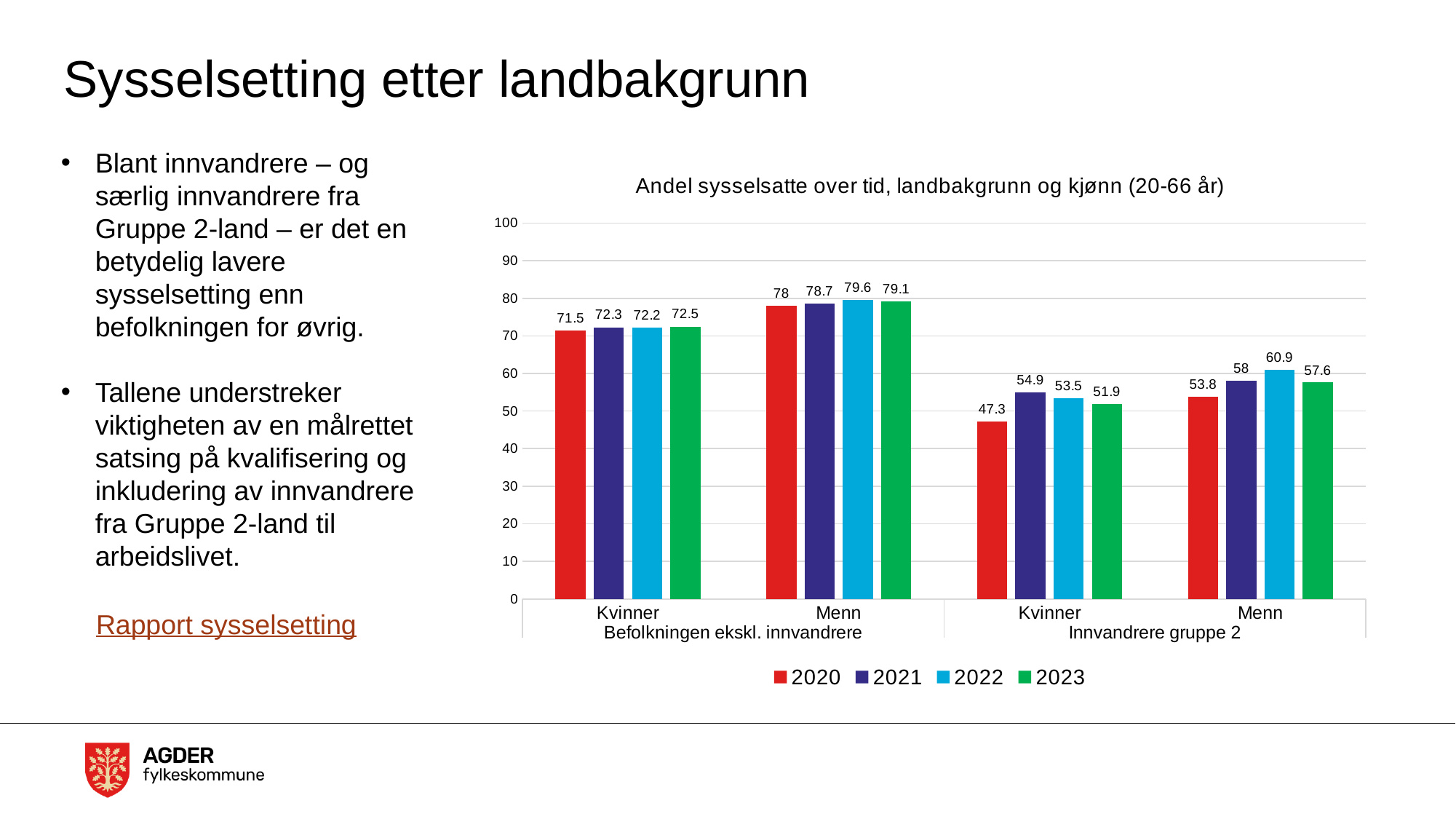
Is the 2020 value for Kvinner in Innvandrere gruppe 2 greater or less than 50? less Which year has the highest value for Menn in Befolkningen ekskl. innvandrere? 2022 What is the value for Menn in Innvandrere gruppe 2 for 2022? 60.9 Do the values for Menn in Befolkningen ekskl. innvandrere rise or fall from 2020 to 2022? Rise Which is larger: the 2021 value for Kvinner in Innvandrere gruppe 2 or the 2021 value for Menn in Innvandrere gruppe 2? Menn in Innvandrere gruppe 2 What is the value for Kvinner in Innvandrere gruppe 2 for 2023? 51.9 What is the difference between the 2023 values for Menn in Befolkningen ekskl. innvandrere and Menn in Innvandrere gruppe 2? 21.5 Which year has the lowest value for Kvinner in Innvandrere gruppe 2? 2020 What is the title of the chart? Andel sysselsatte over tid, landbakgrunn og kjønn (20-66 år) What kind of chart is shown on the slide? Bar chart How many series does the legend list? 4 What is the value for Kvinner in Befolkningen ekskl. innvandrere for 2020? 71.5